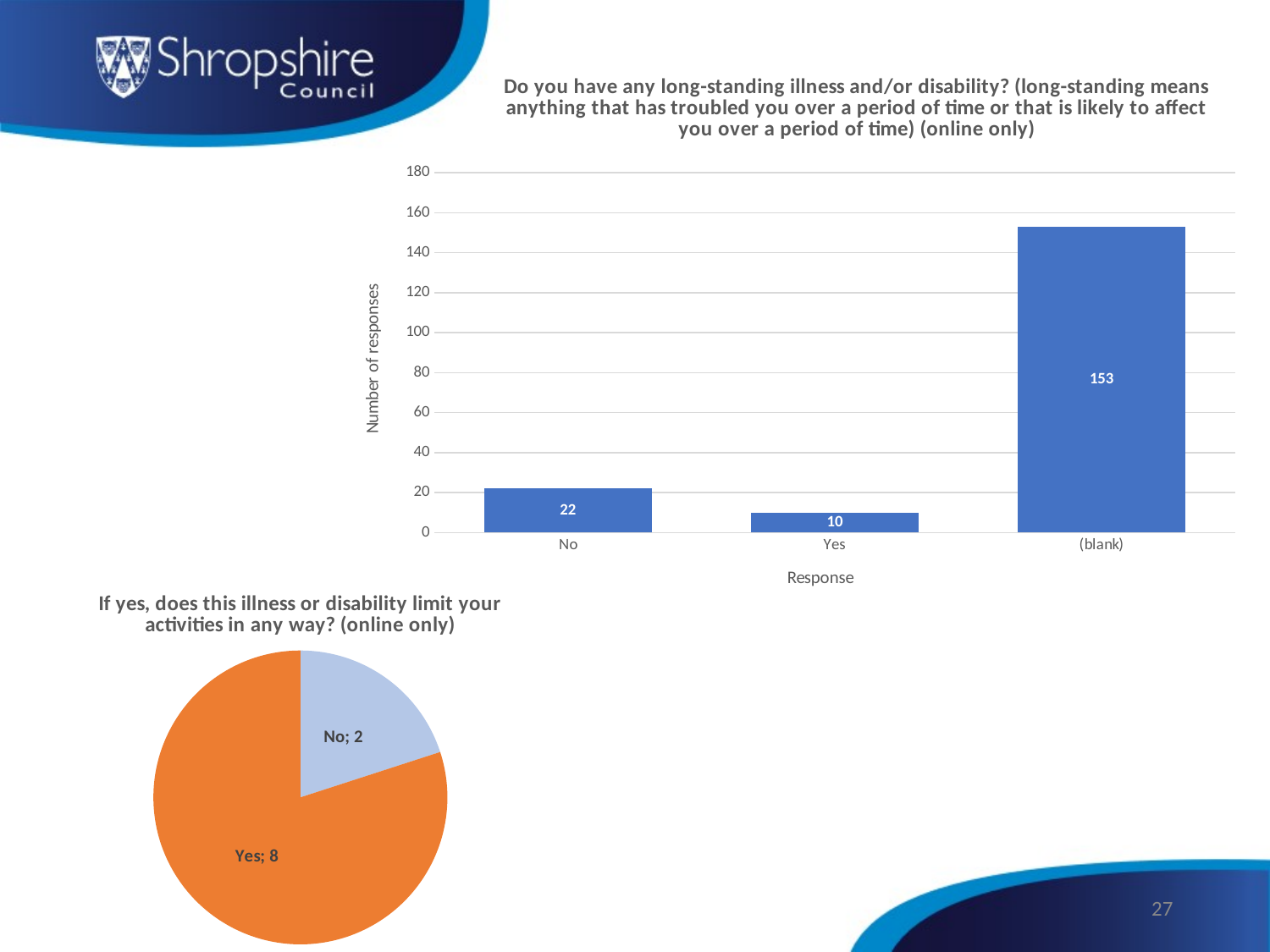
In the bar chart about long-standing illness and/or disability, how many responses were 'No'? 22 In the bar chart about long-standing illness and/or disability, how many responses were 'Yes'? 10 In the pie chart about whether the illness or disability limits activities, how many responses were 'No'? 2 In the bar chart about long-standing illness and/or disability, what is the y-axis label? Number of responses What type of chart is the top chart about long-standing illness and/or disability? Bar chart In the bar chart about long-standing illness and/or disability, how many responses were '(blank)'? 153 In the bar chart about long-standing illness and/or disability, how many response categories are shown on the x axis? 3 In the bar chart about long-standing illness and/or disability, which response category has the highest number of responses? (blank) In the pie chart about whether the illness or disability limits activities, what share of the responses were 'Yes'? 80% In the bar chart about long-standing illness and/or disability, which response category has the lowest number of responses? Yes In the bar chart about long-standing illness and/or disability, what is the difference between the number of 'No' responses and 'Yes' responses? 12 In the pie chart about whether the illness or disability limits activities, how many responses were 'Yes'? 8